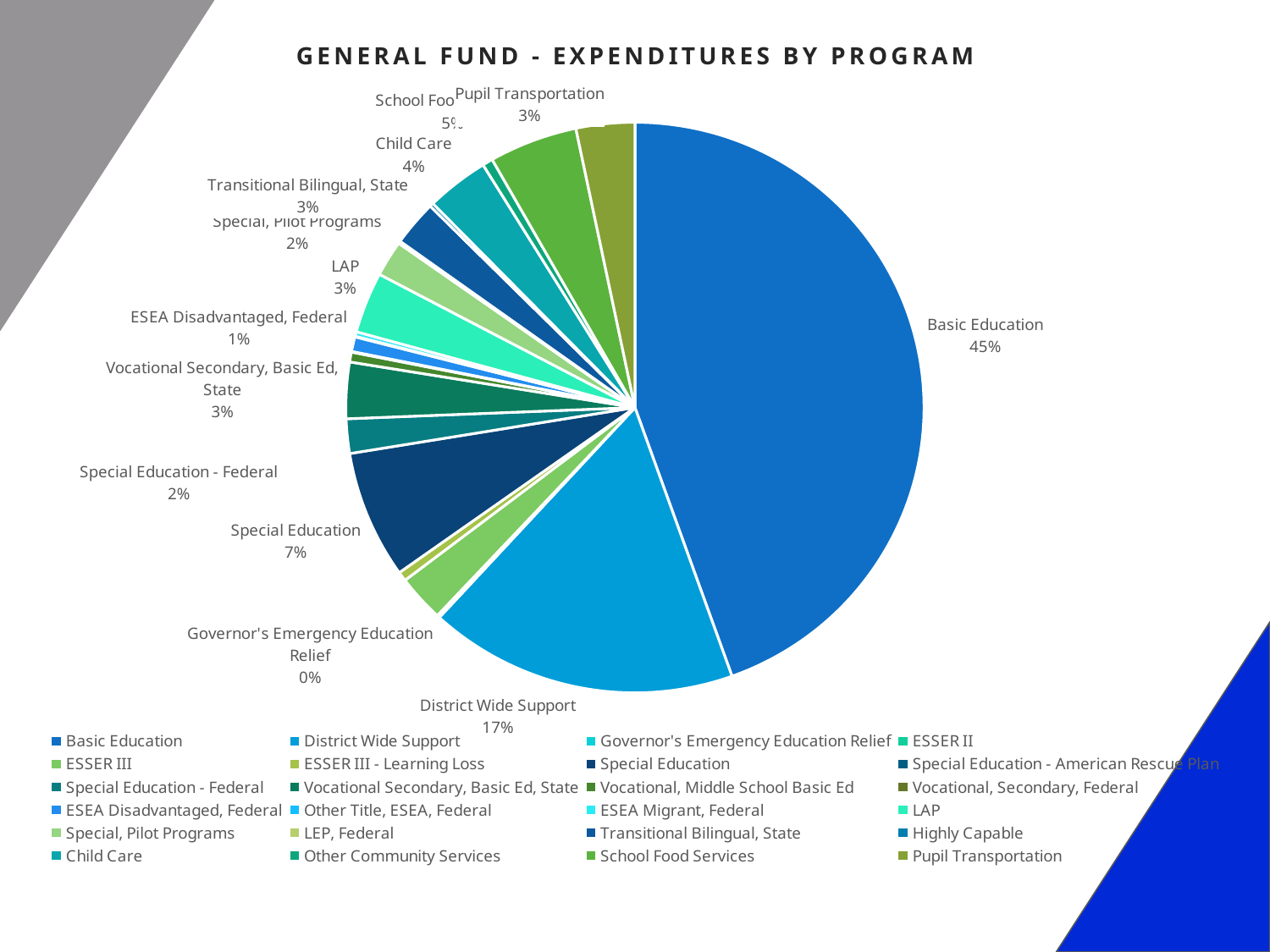
Which program has the largest share of expenditures? Basic Education What share of expenditures goes to Governor's Emergency Education Relief? 0% Which has a larger share, Special Education or Special Education - Federal? Special Education How many percentage points larger is the Basic Education share than the District Wide Support share? 28 percentage points How many programs are listed in the legend? 24 What kind of chart is shown on the slide? pie chart What share of expenditures goes to District Wide Support? 17% What is the title of the chart? GENERAL FUND - EXPENDITURES BY PROGRAM What share of expenditures goes to ESEA Disadvantaged, Federal? 1% What share of expenditures goes to Child Care? 4% What share of expenditures goes to Special Education? 7% What share of expenditures goes to Basic Education? 45%